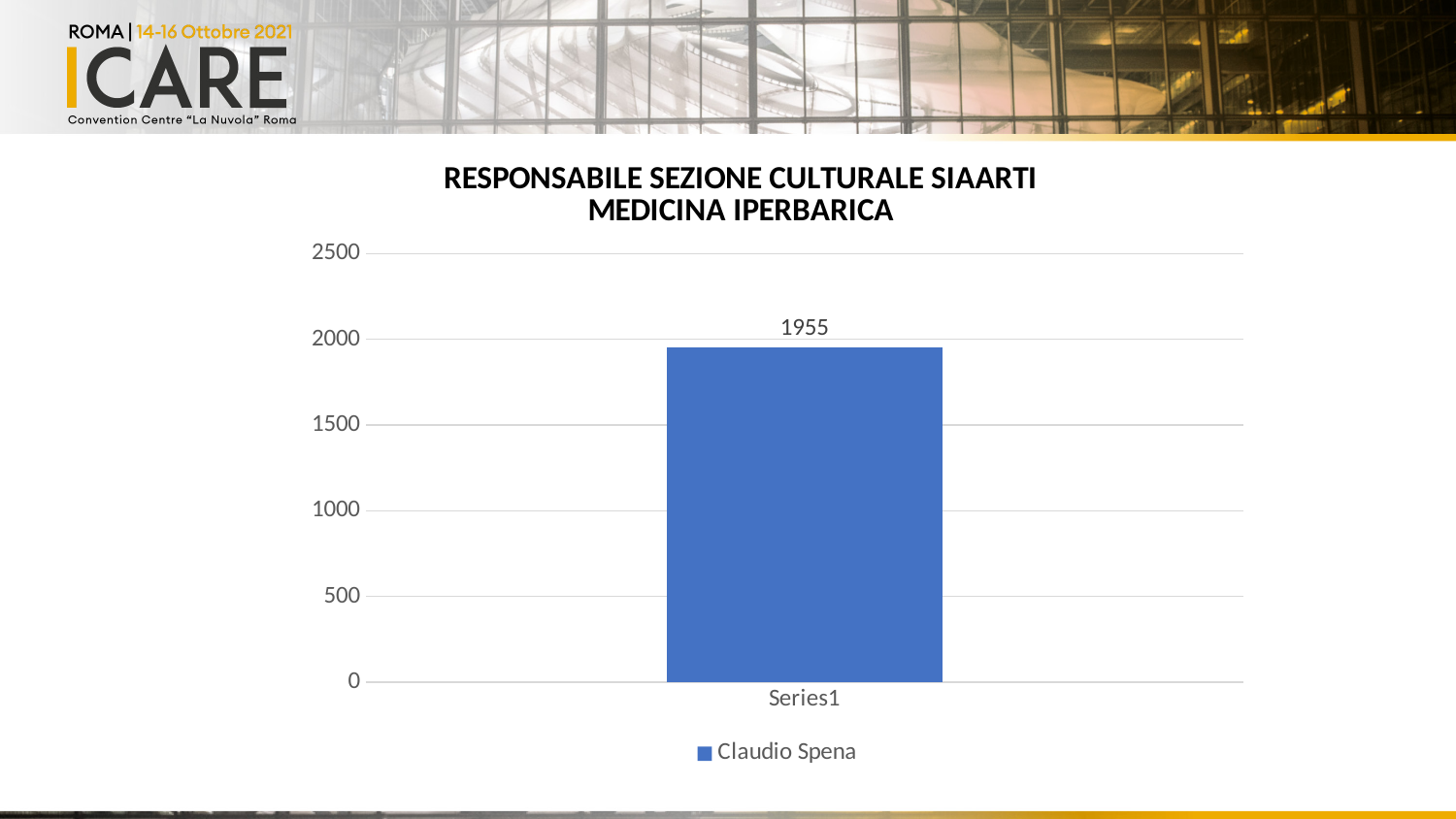
How many series does the legend list? 1 What kind of chart is shown on the slide? bar chart Is the value for Series1 greater or less than 2000? less What value is shown for Claudio Spena? 1955 What is the title of the chart? RESPONSABILE SEZIONE CULTURALE SIAARTI MEDICINA IPERBARICA What is the value of the bar labelled Series1? 1955 How many bars are plotted in the chart? 1 What is the highest value shown on the vertical axis? 2500 What is the category label on the horizontal axis? Series1 Is the value for Series1 greater or less than 1500? greater What is the name of the series shown in the legend? Claudio Spena